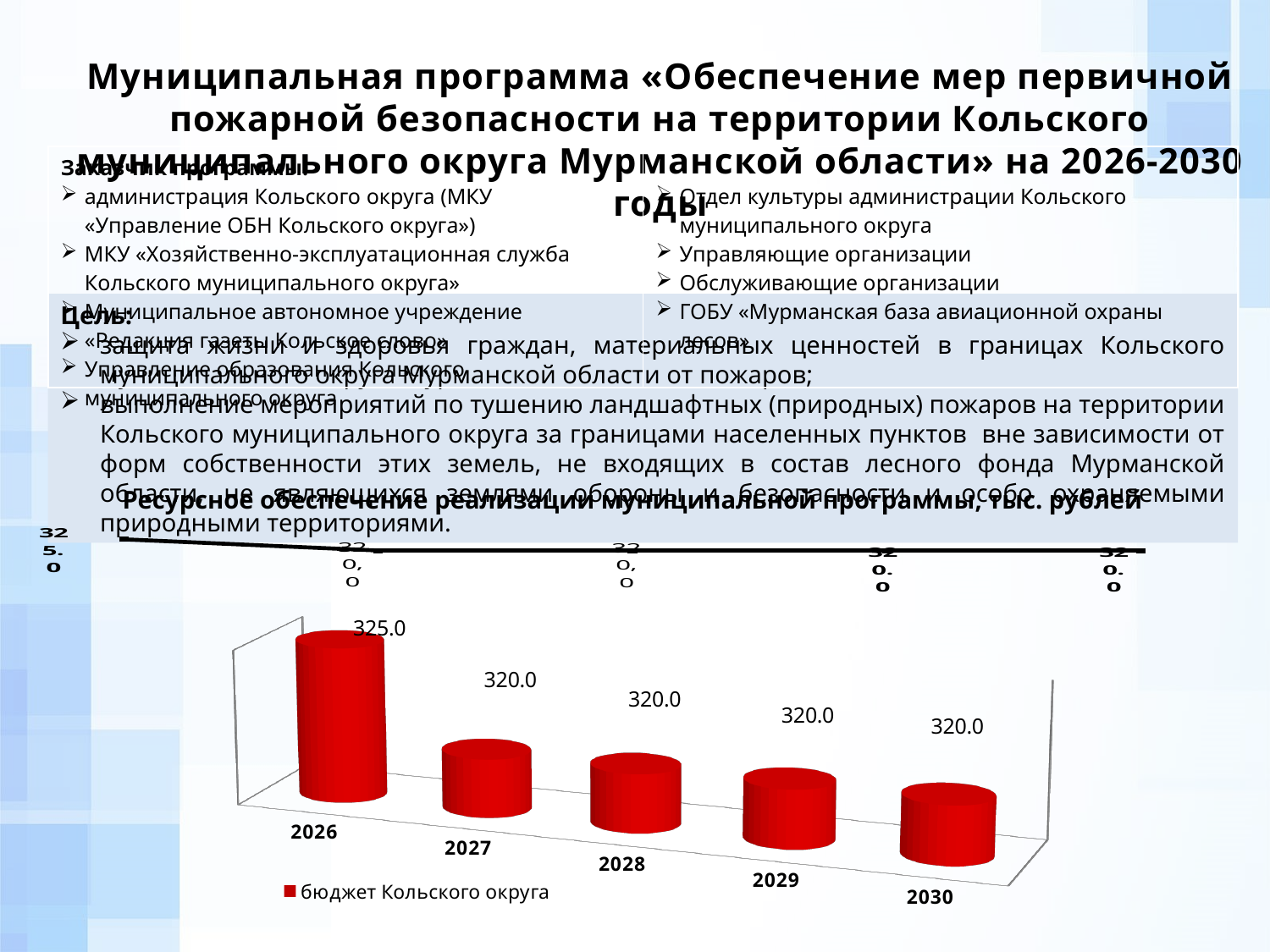
What is the difference between the values for 2026 and 2027? 5.0 How many years (categories) are shown in the chart? 5 What series name is shown in the chart legend? бюджет Кольского округа What unit is stated in the chart title? тыс. рублей What is the value for 2030 in the chart? 320.0 What is the value for 2027 in the chart? 320.0 What is the value for 2026 in the chart? 325.0 Do the values rise or fall from 2026 to 2027? fall How many series does the chart legend list? 1 Which is larger, the value for 2026 or the value for 2029? 2026 What type of chart is shown on the slide? bar chart Which year has the highest value in the chart? 2026